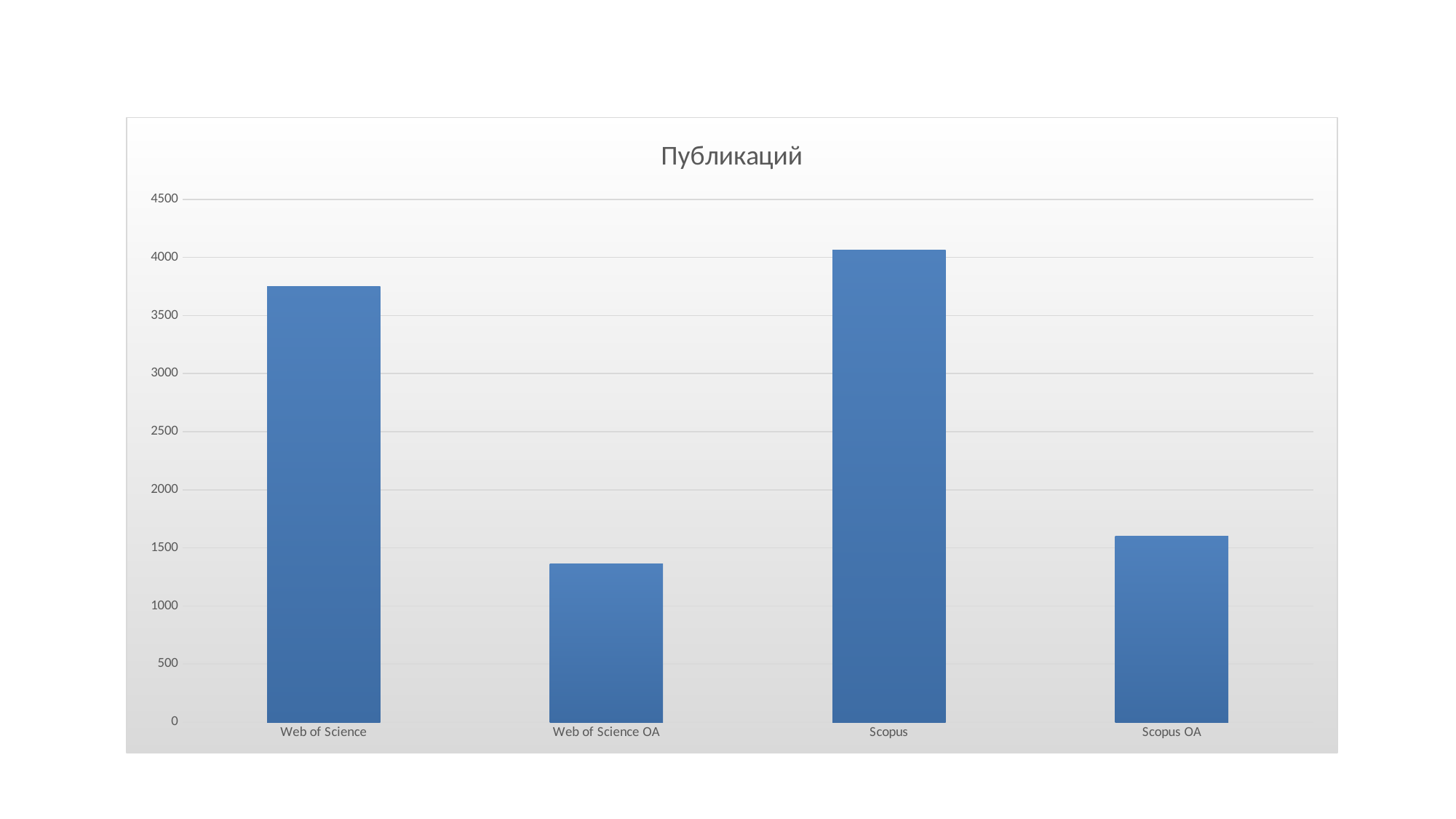
How many categories are shown on the x axis of the chart? 4 What kind of chart is shown on the slide? bar chart What is the title of the chart? Публикаций Which is larger, the value for Web of Science OA or the value for Scopus OA? Scopus OA Is the value for Web of Science OA greater or less than 1500? less Which category has the highest value in the chart? Scopus Is the value for Scopus OA greater or less than 2000? less Is the value for Scopus greater or less than 3500? greater What is the highest value shown on the vertical axis of the chart? 4500 Which category has the lowest value in the chart? Web of Science OA Which is larger, the value for Web of Science or the value for Scopus? Scopus